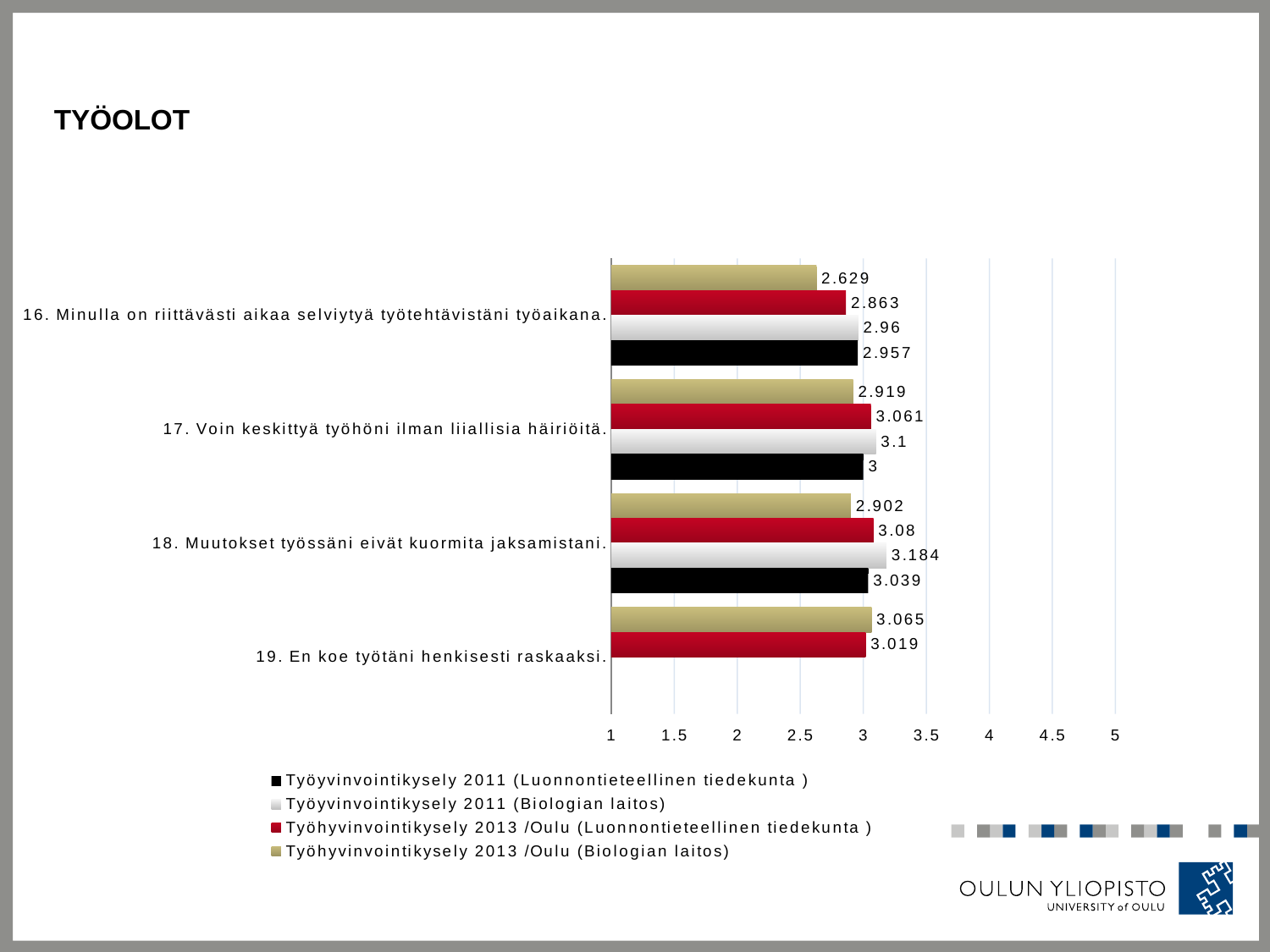
What kind of chart is shown on the slide? bar chart How many categories are shown on the chart? 4 What is the difference between the Työyvinvointikysely 2011 (Biologian laitos) value and the Työhyvinvointikysely 2013 /Oulu (Biologian laitos) value for "18. Muutokset työssäni eivät kuormita jaksamistani."? 0.282 What is the value for "18. Muutokset työssäni eivät kuormita jaksamistani." in the Työyvinvointikysely 2011 (Biologian laitos) series? 3.184 Which category has the highest value in the Työhyvinvointikysely 2013 /Oulu (Biologian laitos) series? 19. En koe työtäni henkisesti raskaaksi. Is the value for "16. Minulla on riittävästi aikaa selviytyä työtehtävistäni työaikana." in the Työhyvinvointikysely 2013 /Oulu (Biologian laitos) series greater or less than 3? less What is the value for "19. En koe työtäni henkisesti raskaaksi." in the Työhyvinvointikysely 2013 /Oulu (Luonnontieteellinen tiedekunta ) series? 3.019 What is the value for "16. Minulla on riittävästi aikaa selviytyä työtehtävistäni työaikana." in the Työhyvinvointikysely 2013 /Oulu (Biologian laitos) series? 2.629 Which category has the lowest value in the Työhyvinvointikysely 2013 /Oulu (Luonnontieteellinen tiedekunta ) series? 16. Minulla on riittävästi aikaa selviytyä työtehtävistäni työaikana. What is the value for "17. Voin keskittyä työhöni ilman liiallisia häiriöitä." in the Työyvinvointikysely 2011 (Luonnontieteellinen tiedekunta ) series? 3 For "17. Voin keskittyä työhöni ilman liiallisia häiriöitä.", which is larger: the Työhyvinvointikysely 2013 /Oulu (Luonnontieteellinen tiedekunta ) value or the Työhyvinvointikysely 2013 /Oulu (Biologian laitos) value? Työhyvinvointikysely 2013 /Oulu (Luonnontieteellinen tiedekunta ) How many series does the legend list? 4